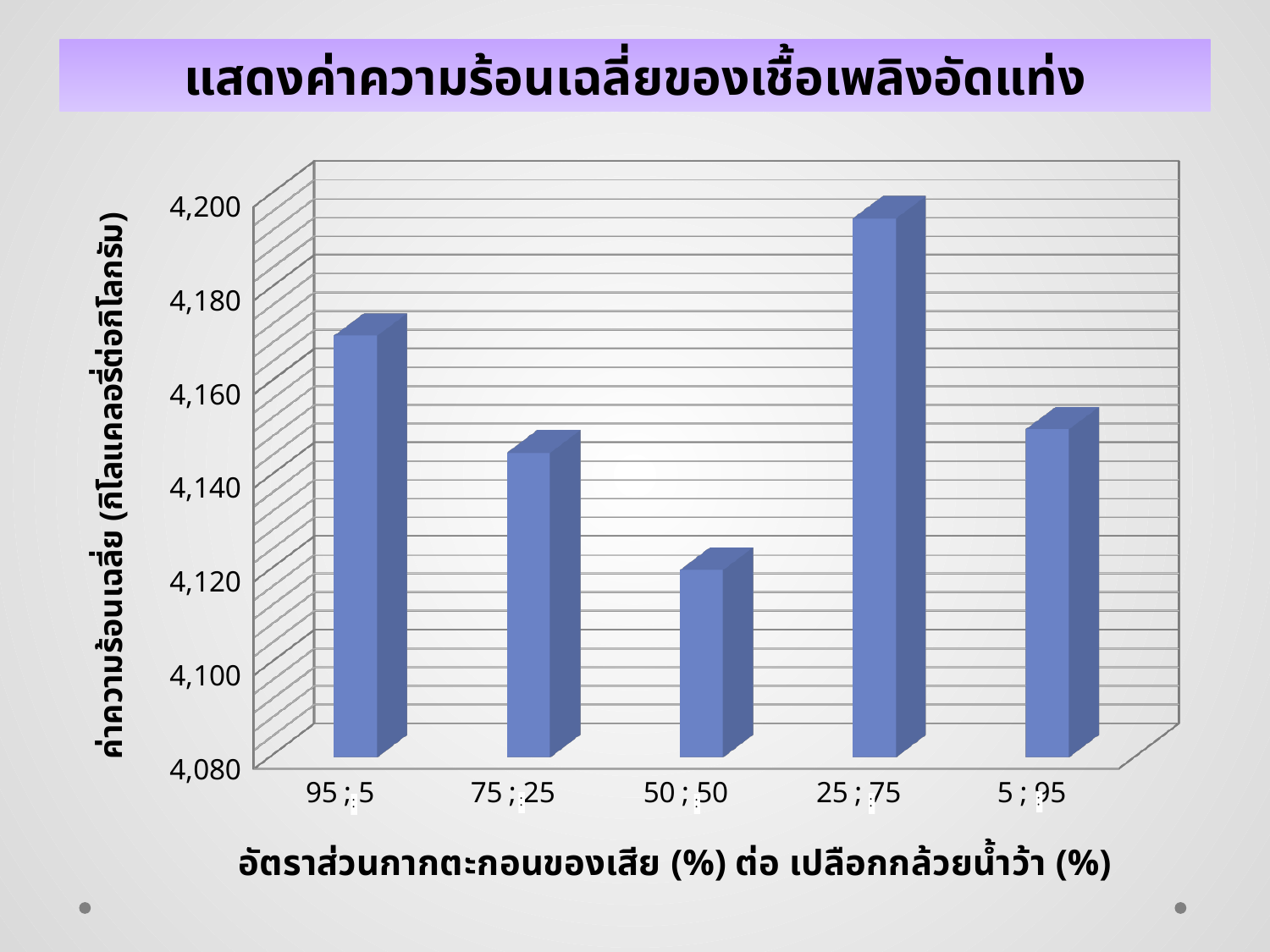
Which is larger, the value for 95 ; 5 or the value for 75 ; 25? 95 ; 5 What kind of chart is shown on the slide? bar chart Is the value for 95 ; 5 greater or less than 4,160? greater Do the values rise or fall from 95 ; 5 to 50 ; 50 along the x axis? fall Which category has the highest bar? 25 ; 75 What is the title of the chart? แสดงค่าความร้อนเฉลี่ยของเชื้อเพลิงอัดแท่ง Which is larger, the value for 25 ; 75 or the value for 5 ; 95? 25 ; 75 Is the value for 50 ; 50 greater or less than 4,140? less Which category has the lowest bar? 50 ; 50 How many categories are plotted on the x axis? 5 Is the value for 25 ; 75 greater or less than 4,180? greater